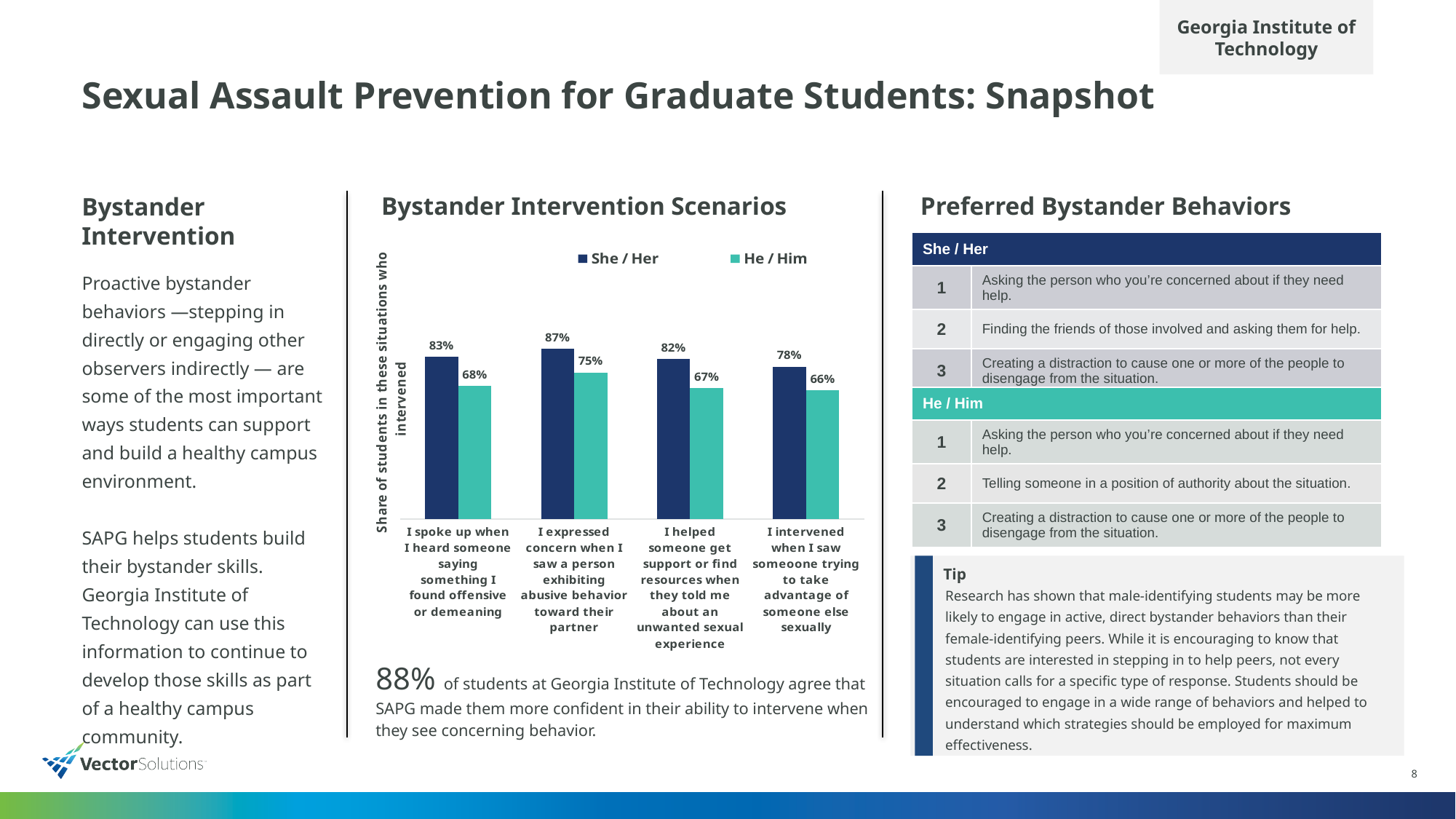
Which scenario has the highest She / Her value? I expressed concern when I saw a person exhibiting abusive behavior toward their partner What kind of chart is the Bystander Intervention Scenarios chart? Bar chart How many scenarios are shown on the x axis of the Bystander Intervention Scenarios chart? 4 What is the difference between the She / Her and He / Him values for "I helped someone get support or find resources when they told me about an unwanted sexual experience"? 15% What is the y-axis label of the Bystander Intervention Scenarios chart? Share of students in these situations who intervened What is the She / Her value for "I spoke up when I heard someone saying something I found offensive or demeaning"? 83% What is the title of the chart on the slide? Bystander Intervention Scenarios Which scenario has the lowest He / Him value? I intervened when I saw someone trying to take advantage of someone else sexually What is the He / Him value for "I intervened when I saw someone trying to take advantage of someone else sexually"? 66% What is the He / Him value for "I expressed concern when I saw a person exhibiting abusive behavior toward their partner"? 75% Which is larger for "I spoke up when I heard someone saying something I found offensive or demeaning": the She / Her value or the He / Him value? She / Her How many series does the legend of the Bystander Intervention Scenarios chart list? 2